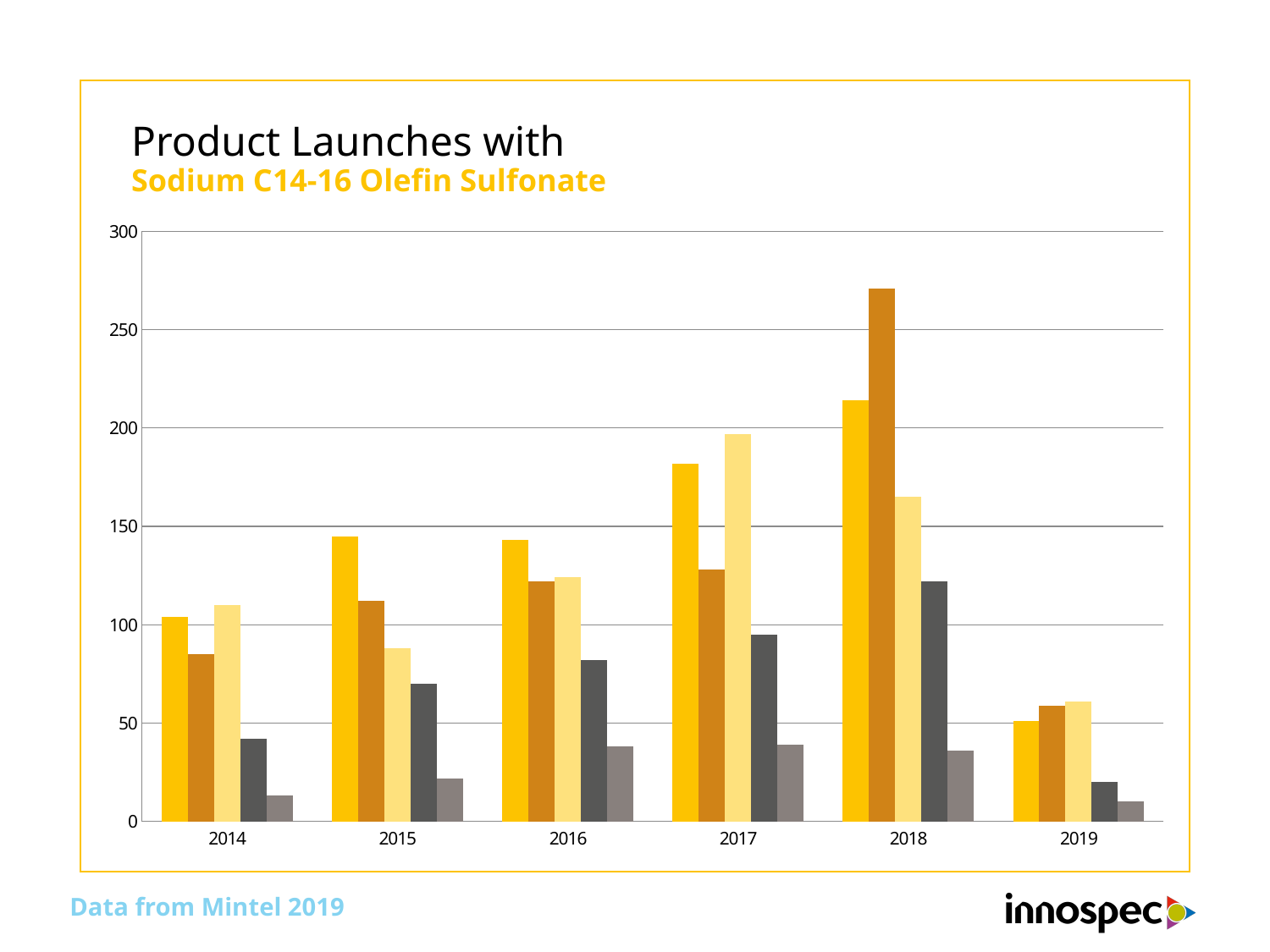
How many years are shown along the x axis of the chart? 6 Is the value of the light yellow bar for 2017 greater or less than 150? greater Is the value of the dark grey bar for 2014 greater or less than 50? less Is the value of the bright yellow (first) bar for 2018 greater or less than 200? greater Which year contains the tallest bar in the chart? 2018 How many bars are plotted for each year in the chart? 5 What kind of chart is shown on the slide? bar chart What is the highest value shown on the chart's vertical axis? 300 In 2018, which is larger: the bright yellow (first) bar or the dark orange (second) bar? the dark orange bar